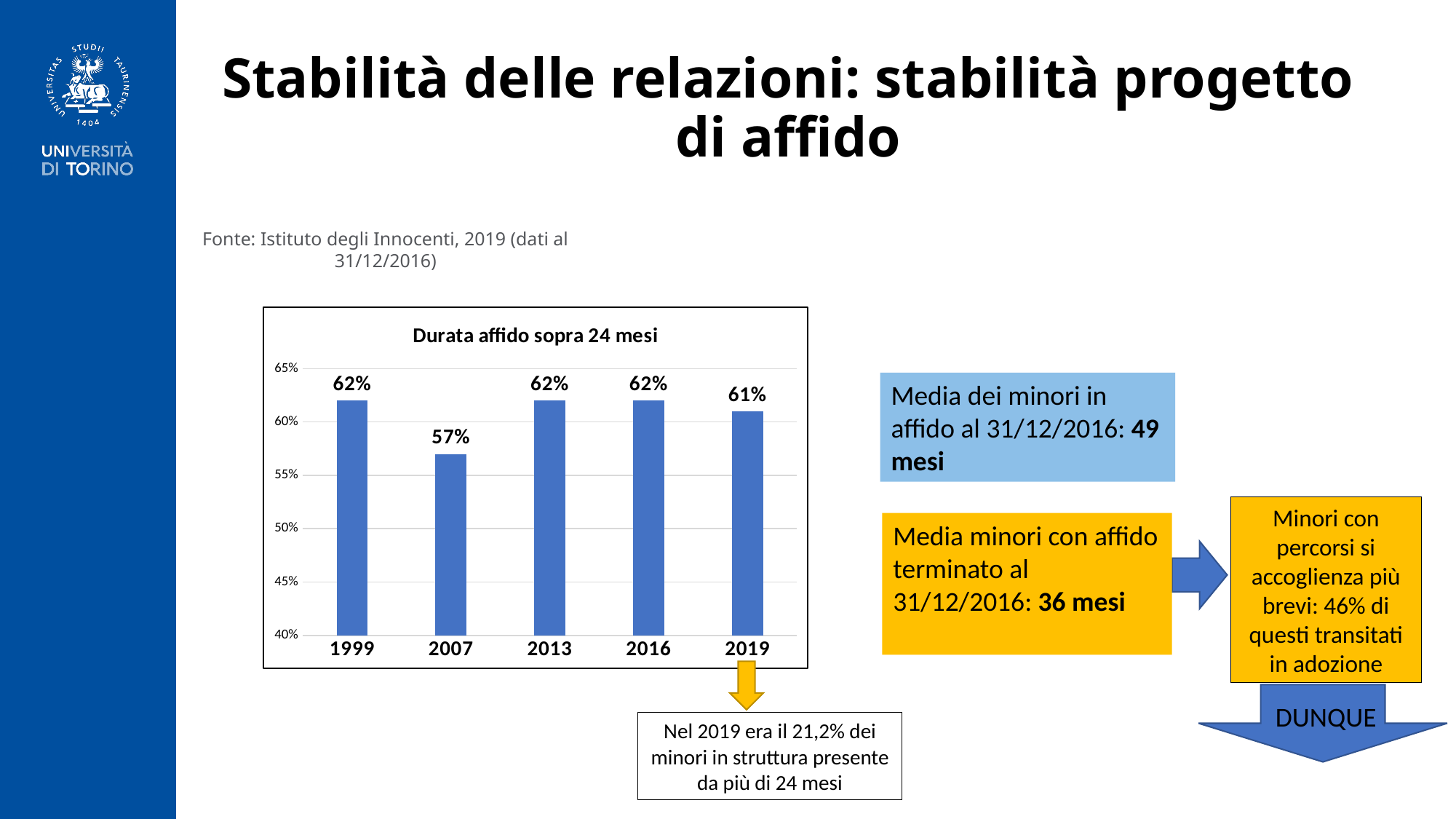
Which year has the lowest value in the chart? 2007 Is the value for 2013 greater or less than 60%? greater Which is larger, the value for 2007 or the value for 2019? 2019 What is the value for 2007 in the chart? 57% Did the value rise or fall from 1999 to 2007? fall What is the value for 2019 in the chart? 61% What is the difference between the values for 2016 and 2007? 5 percentage points What is the value for 1999 in the chart? 62% What kind of chart is shown on the slide? bar chart What is the title of the chart? Durata affido sopra 24 mesi Is the value for 2007 greater or less than 60%? less How many years are shown on the x axis of the chart? 5